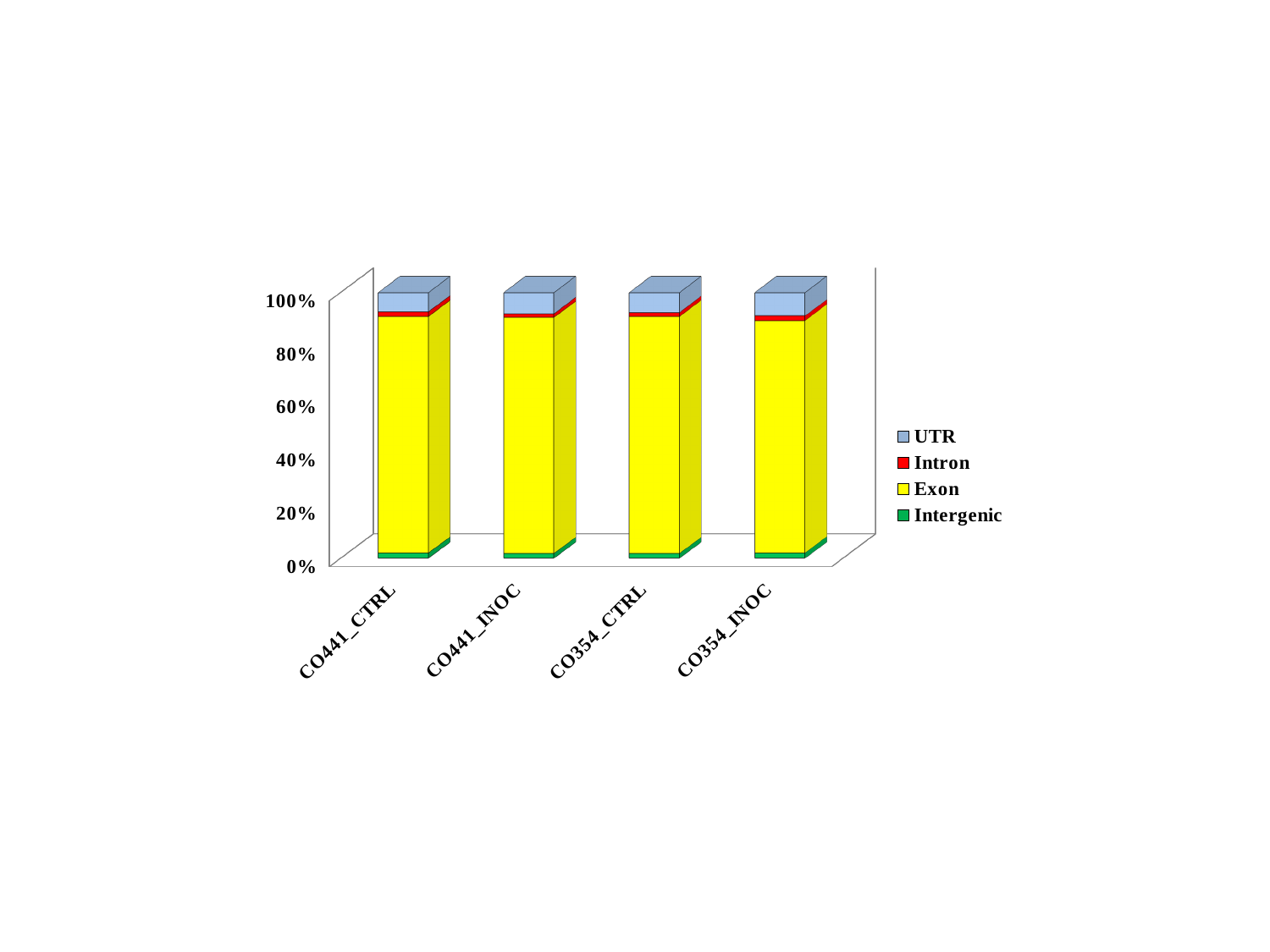
Which series is shown in yellow? Exon Which series makes up the largest segment of every bar? Exon Is the Exon value for CO441_CTRL greater or less than 60%? greater Is the UTR value for CO441_INOC greater or less than 20%? less What are the series listed in the legend? UTR, Intron, Exon, Intergenic Is the Intergenic value for CO354_INOC greater or less than 20%? less How many categories are shown along the x axis? 4 Which category is the first one on the x axis? CO441_CTRL How many series does the legend list? 4 What kind of chart is shown on the slide? Stacked bar chart